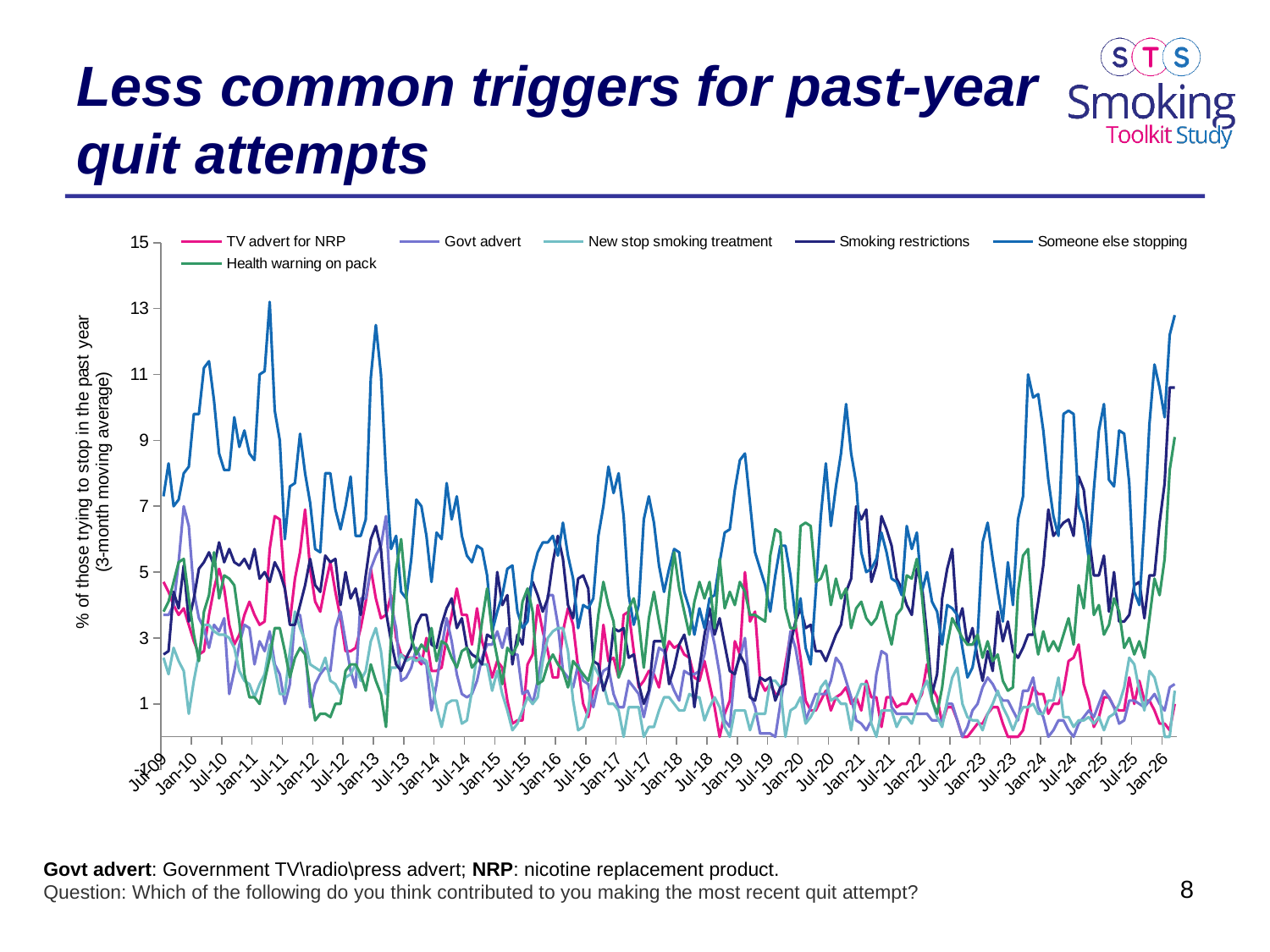
Is the value for Someone else stopping at Jul-11 greater or less than 11? less What is the title of the slide? Less common triggers for past-year quit attempts Is the value for New stop smoking treatment at Jan-26 greater or less than 3? less What is the title of the chart's y axis? % of those trying to stop in the past year (3-month moving average) How many series does the legend list? 6 At Jul-11, which is larger: Someone else stopping or TV advert for NRP? Someone else stopping Does the TV advert for NRP series rise or fall between Jan-19 and Jan-26? Fall What kind of chart is shown on the slide? Line chart Which series has the highest values across most of the chart? Someone else stopping Is the value for Smoking restrictions at Jan-26 greater or less than 9? less At Jan-26, which is larger: Someone else stopping or Smoking restrictions? Someone else stopping